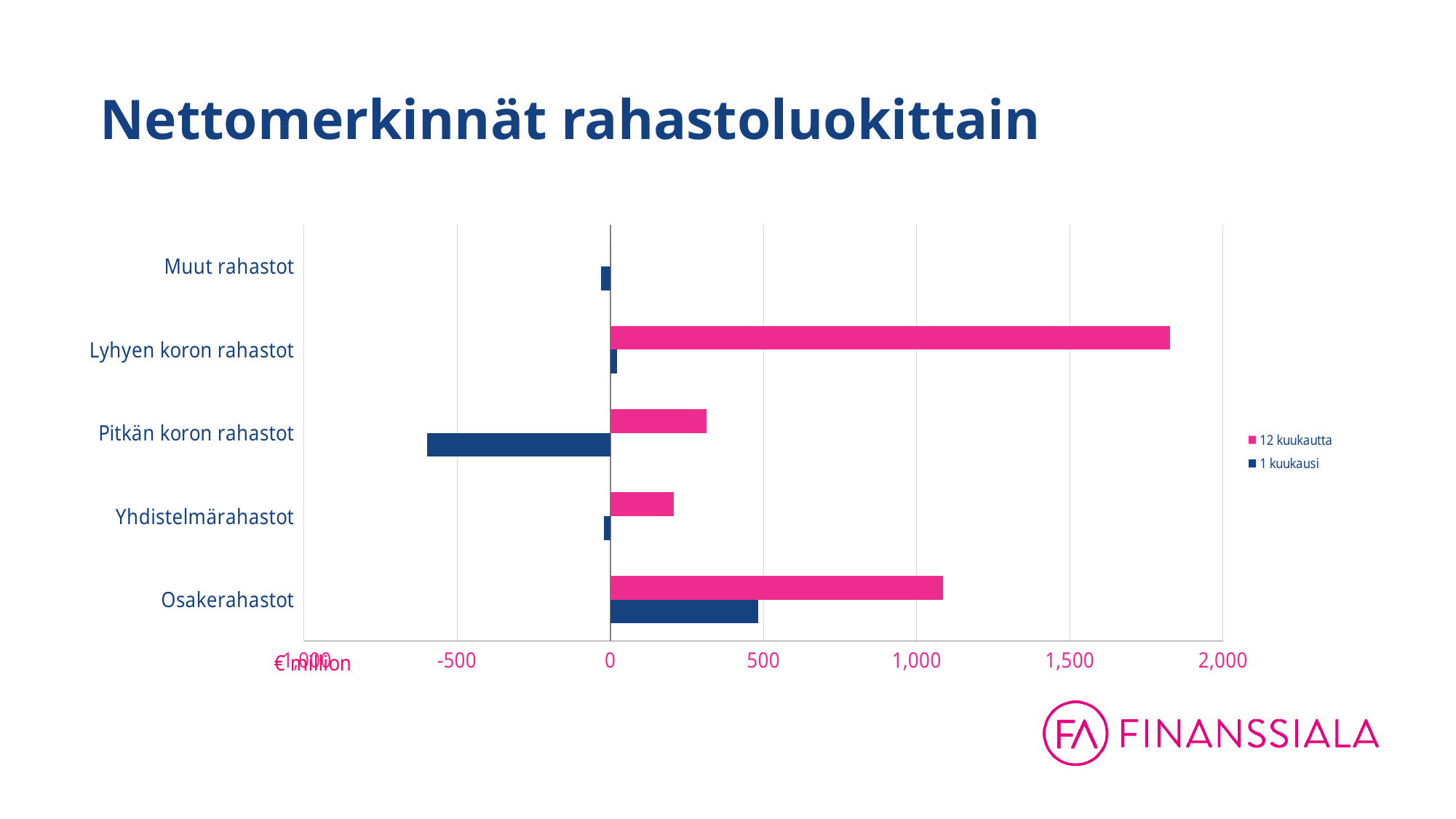
Which category has the lowest value for the 1 kuukausi series? Pitkän koron rahastot What is the title of the chart on the slide? Nettomerkinnät rahastoluokittain What kind of chart is shown on the slide? bar chart For Pitkän koron rahastot, which series has the larger value: 12 kuukautta or 1 kuukausi? 12 kuukautta Which category has the highest value for the 1 kuukausi series? Osakerahastot Is the 12 kuukautta value for Osakerahastot greater or less than 1,000? greater How many fund categories are listed on the vertical axis? 5 Is the 1 kuukausi value for Pitkän koron rahastot greater or less than -500? less How many series does the legend list? 2 Which category has the highest value for the 12 kuukautta series? Lyhyen koron rahastot Is the 12 kuukautta value for Lyhyen koron rahastot greater or less than 1,500? greater